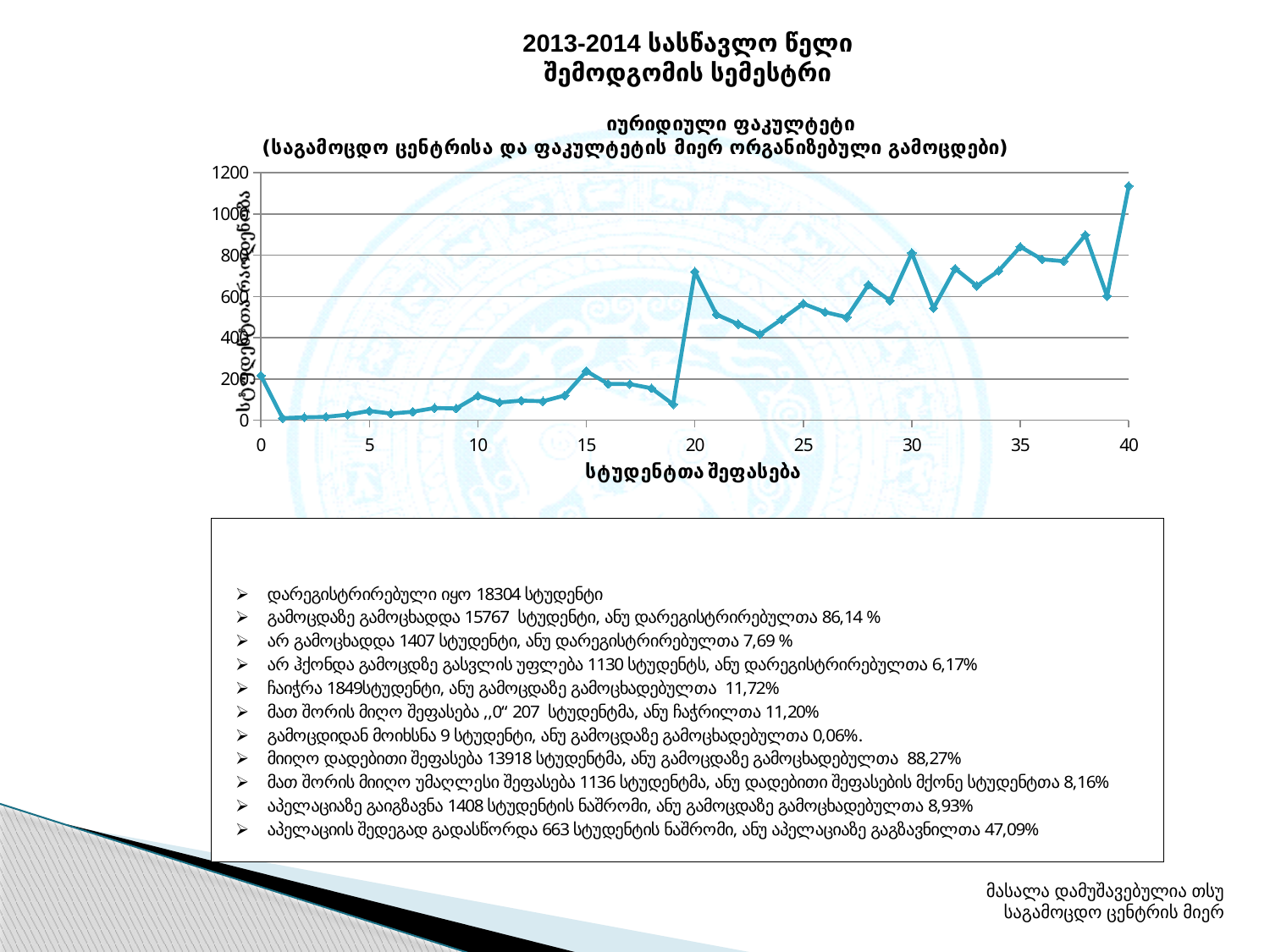
Is the value at x = 20 greater or less than 600? greater Is the value at x = 30 greater or less than 600? greater Is the value at x = 19 greater or less than 200? less Overall, do the values rise or fall as the x-axis value increases from 0 to 40? rise Which has the larger value: the point at x = 0 or the point at x = 40? x = 40 At which x-axis value (student score) does the line reach its highest point? 40 Which has the larger value: the point at x = 20 or the point at x = 19? x = 20 What kind of chart is shown on the slide? line chart What is the title of the x-axis? სტუდენტთა შეფასება What is the highest value shown on the y-axis? 1200